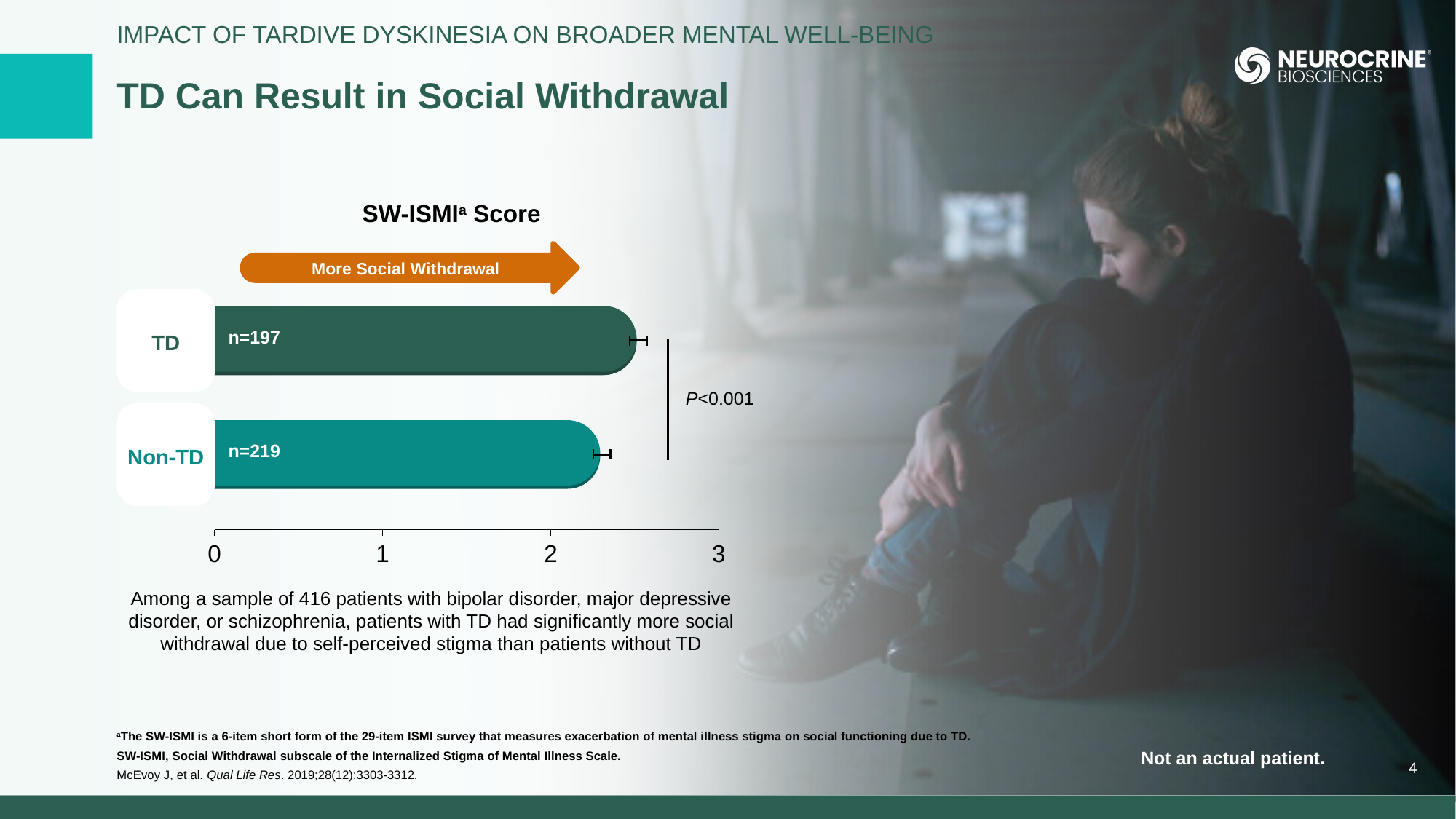
Which group has the highest SW-ISMI score? TD Is the SW-ISMI score for the TD group greater or less than 3? less How many bars (groups) are plotted in the chart? 2 What is the title of the chart? SW-ISMI Score Is the SW-ISMI score for the Non-TD group greater or less than 2? greater What is the sample size (n) shown on the Non-TD bar? n=219 Which group has the higher SW-ISMI score, TD or Non-TD? TD Which group has the lowest SW-ISMI score? Non-TD What is the sample size (n) shown on the TD bar? n=197 Is the SW-ISMI score for the TD group greater or less than 2? greater What P value is shown between the two bars in the chart? P<0.001 What kind of chart is shown on the slide? bar chart